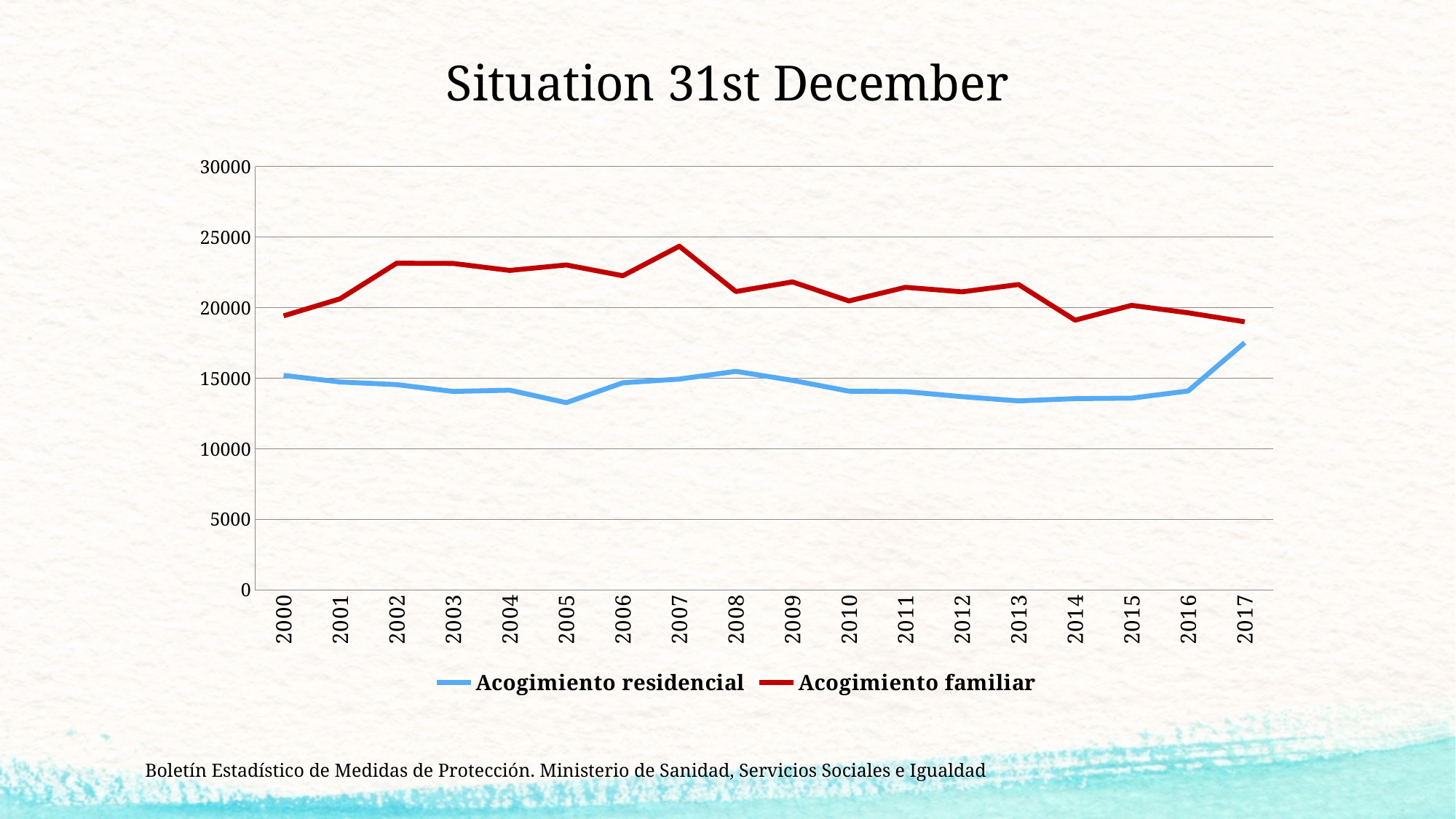
Which series is drawn in red? Acogimiento familiar How many series does the legend list? 2 In which year does Acogimiento residencial reach its highest value? 2017 How many years are plotted along the x axis? 18 In 2010, which series has the higher value, Acogimiento residencial or Acogimiento familiar? Acogimiento familiar Is the value for Acogimiento residencial in 2017 greater or less than 15000? greater What kind of chart is shown on the slide? line chart Is the value for Acogimiento familiar in 2007 greater or less than 20000? greater Does the Acogimiento residencial line rise or fall from 2016 to 2017? rise Is the value for Acogimiento familiar in 2014 greater or less than 20000? less In which year does Acogimiento familiar reach its highest value? 2007